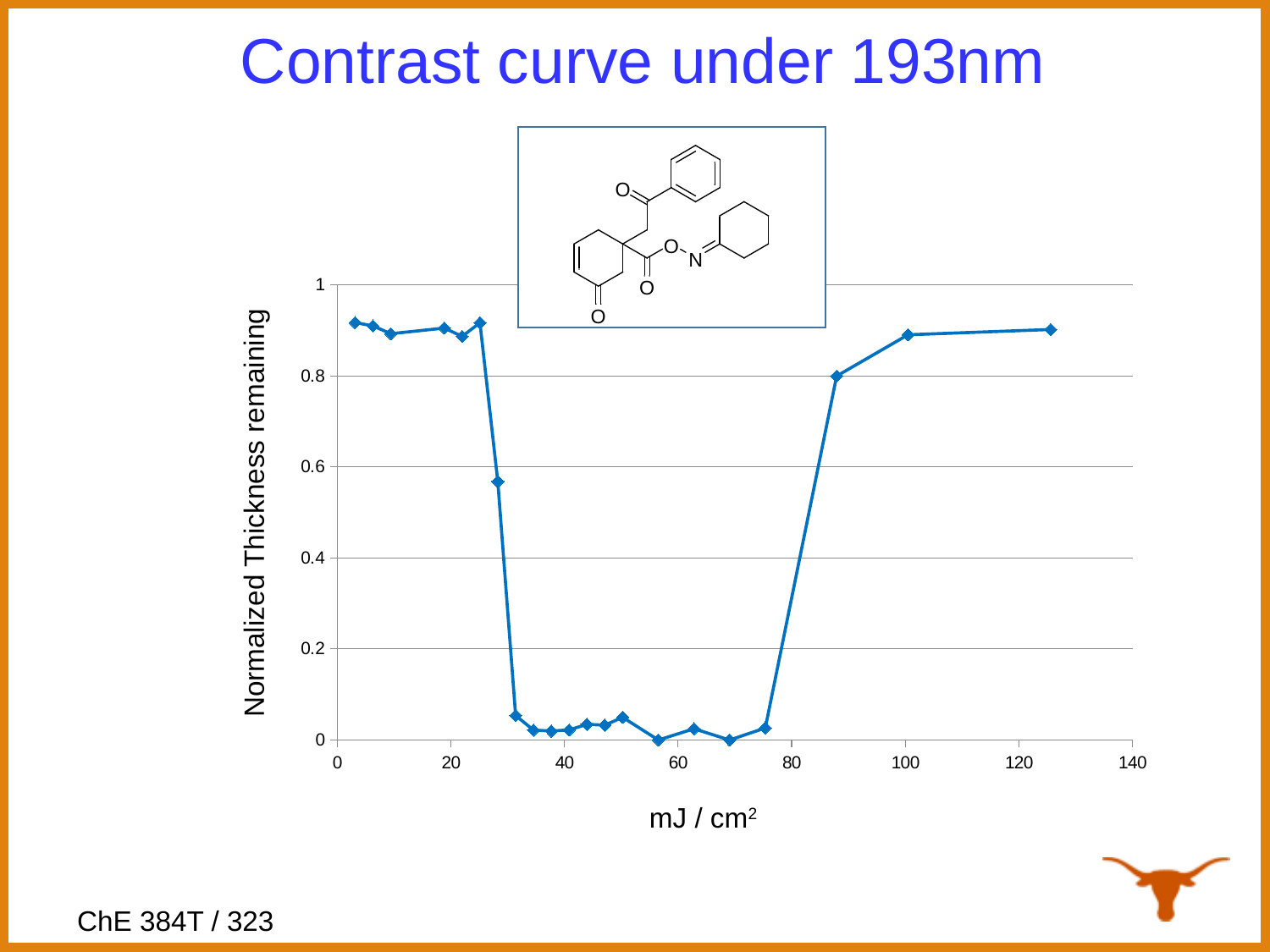
Which has the larger normalized thickness remaining: the point at about 20 mJ/cm² or the point at about 40 mJ/cm²? the point at about 20 mJ/cm² Is the normalized thickness remaining at a dose of about 60 mJ/cm² greater or less than 0.2? less Is the normalized thickness remaining at a dose of about 125 mJ/cm² greater or less than 0.6? greater Between doses of about 75 and 100 mJ/cm², does the normalized thickness remaining rise or fall? rise What is the title of the chart on the slide? Contrast curve under 193nm Between doses of about 25 and 35 mJ/cm², does the normalized thickness remaining rise or fall? fall Is the normalized thickness remaining at a dose of about 10 mJ/cm² greater or less than 0.8? greater What kind of chart is shown on the slide? line chart What is the label of the y axis of the chart? Normalized Thickness remaining Which has the larger normalized thickness remaining: the point at about 60 mJ/cm² or the point at about 100 mJ/cm²? the point at about 100 mJ/cm²